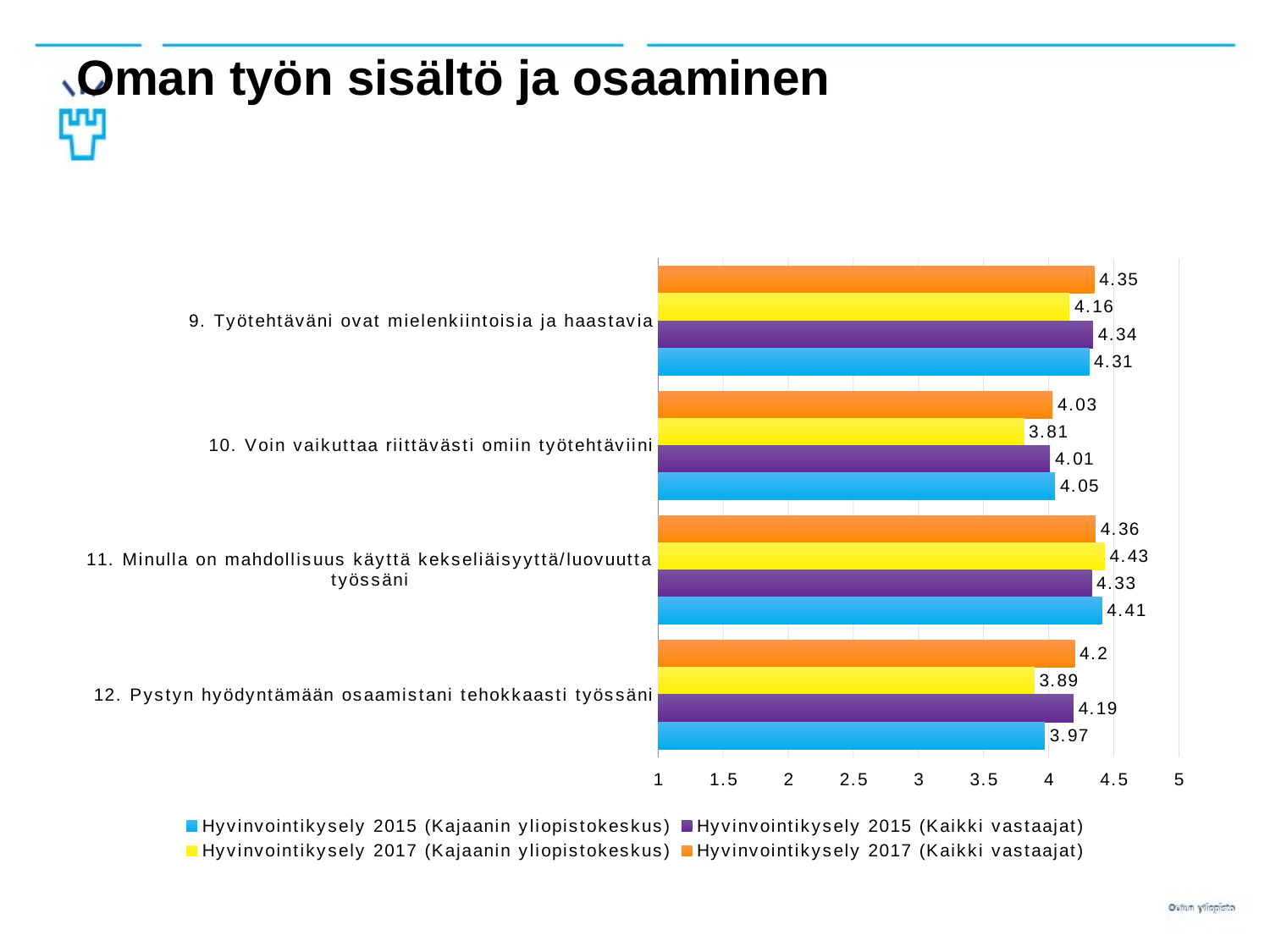
What is the value for "10. Voin vaikuttaa riittävästi omiin työtehtäviini" in the Hyvinvointikysely 2017 (Kajaanin yliopistokeskus) series? 3.81 Which category has the highest value in the Hyvinvointikysely 2017 (Kajaanin yliopistokeskus) series? 11. Minulla on mahdollisuus käyttä kekseliäisyyttä/luovuutta työssäni What is the value for "12. Pystyn hyödyntämään osaamistani tehokkaasti työssäni" in the Hyvinvointikysely 2015 (Kajaanin yliopistokeskus) series? 3.97 For "10. Voin vaikuttaa riittävästi omiin työtehtäviini", which is larger: the Hyvinvointikysely 2015 (Kajaanin yliopistokeskus) value or the Hyvinvointikysely 2017 (Kajaanin yliopistokeskus) value? Hyvinvointikysely 2015 (Kajaanin yliopistokeskus) What is the difference between the Hyvinvointikysely 2017 (Kaikki vastaajat) and Hyvinvointikysely 2017 (Kajaanin yliopistokeskus) values for "12. Pystyn hyödyntämään osaamistani tehokkaasti työssäni"? 0.31 What is the value for "9. Työtehtäväni ovat mielenkiintoisia ja haastavia" in the Hyvinvointikysely 2017 (Kaikki vastaajat) series? 4.35 How many categories (survey statements) are shown on the chart? 4 What kind of chart is shown on the slide? Bar chart What is the title of the slide? Oman työn sisältö ja osaaminen How many series does the legend list? 4 Which category has the lowest value in the Hyvinvointikysely 2015 (Kajaanin yliopistokeskus) series? 12. Pystyn hyödyntämään osaamistani tehokkaasti työssäni What is the value for "11. Minulla on mahdollisuus käyttä kekseliäisyyttä/luovuutta työssäni" in the Hyvinvointikysely 2015 (Kaikki vastaajat) series? 4.33